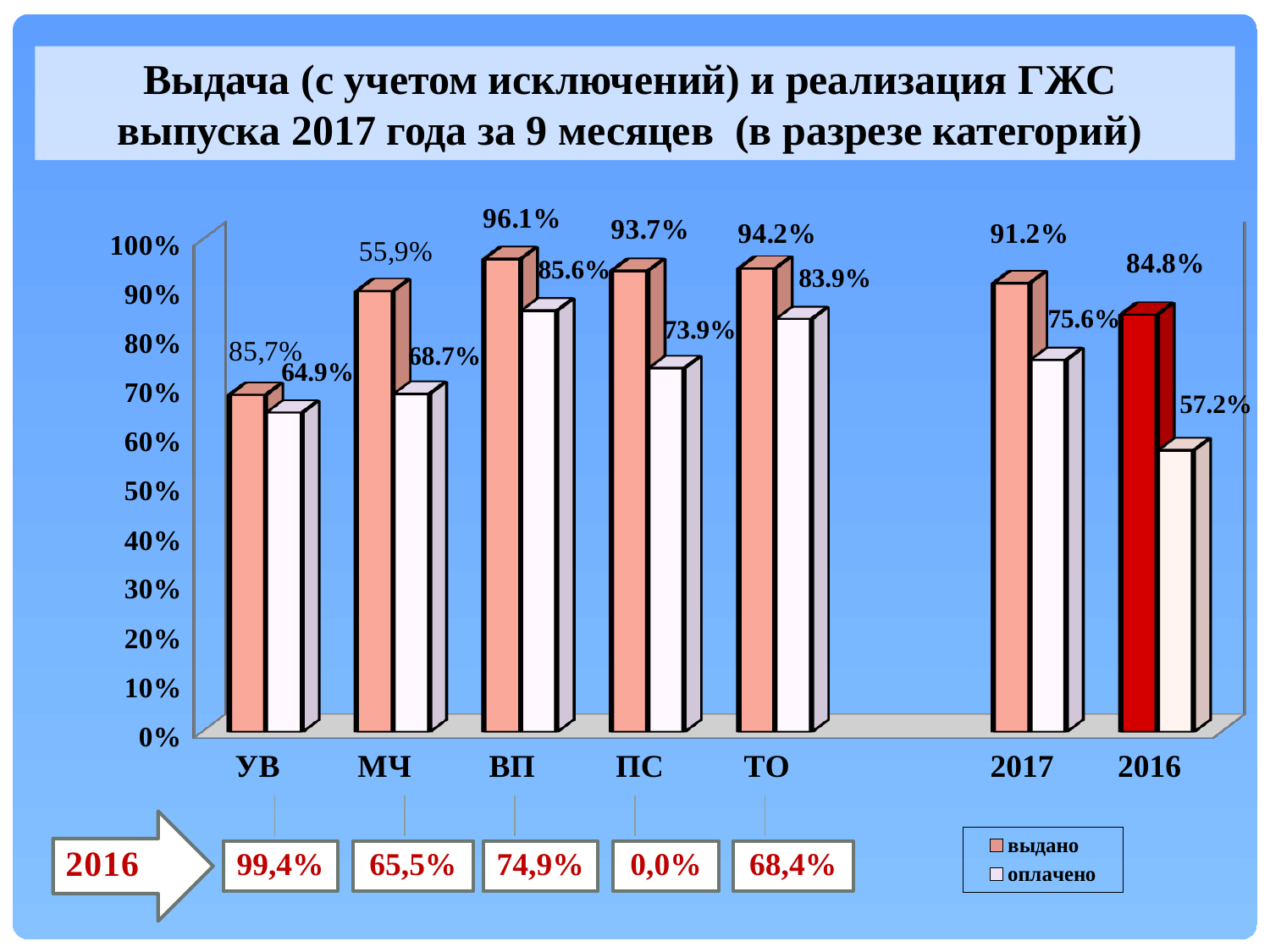
What is the value of the оплачено bar for ПС? 73.9% What kind of chart is shown on the slide? Bar chart What is the value of the выдано bar for ВП? 96.1% Which category has the highest выдано bar? ВП Which category has the lowest оплачено bar? 2016 How many categories are shown on the x axis? 7 What is the value of the оплачено bar for 2016? 57.2% Which is larger, the оплачено value for ТО or for ПС? ТО What is the value of the выдано bar for ТО? 94.2% How many series does the legend list? 2 What is the difference between the выдано and оплачено values for ВП? 10.5 percentage points What is the difference between the выдано values for 2017 and 2016? 6.4 percentage points